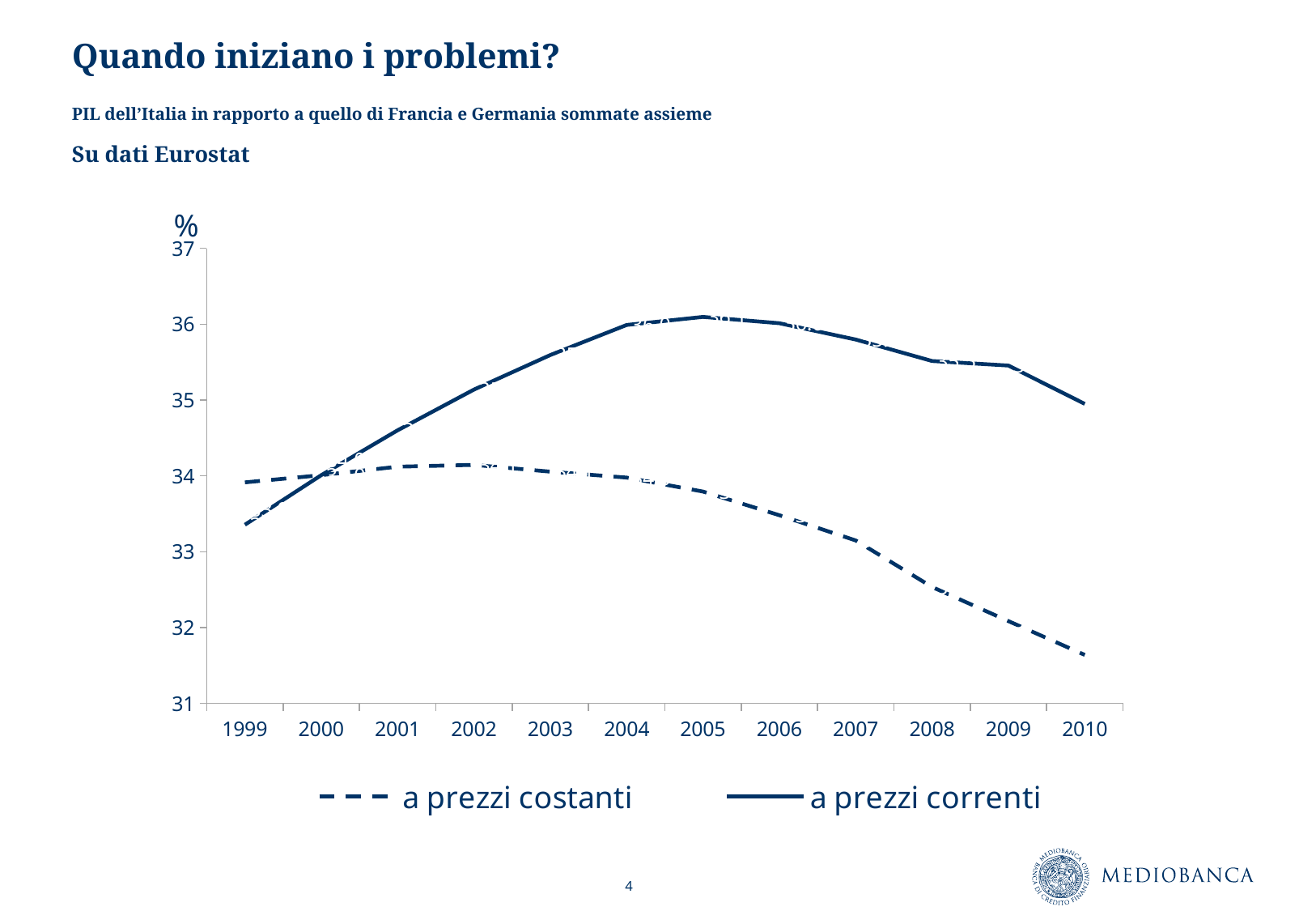
What kind of chart is shown on the slide? line chart Which series is drawn with a dashed line? a prezzi costanti What is the unit shown on the y axis? % How many years are plotted along the x axis? 12 In 1999, which series has the higher value, 'a prezzi costanti' or 'a prezzi correnti'? a prezzi costanti Is the value for 'a prezzi correnti' in 2003 greater or less than 35? greater How many series does the legend list? 2 In 2010, which series has the higher value, 'a prezzi costanti' or 'a prezzi correnti'? a prezzi correnti In which year is the 'a prezzi costanti' series at its lowest? 2010 Is the value for 'a prezzi correnti' in 1999 greater or less than 33? greater Is the value for 'a prezzi costanti' in 2010 greater or less than 32? less